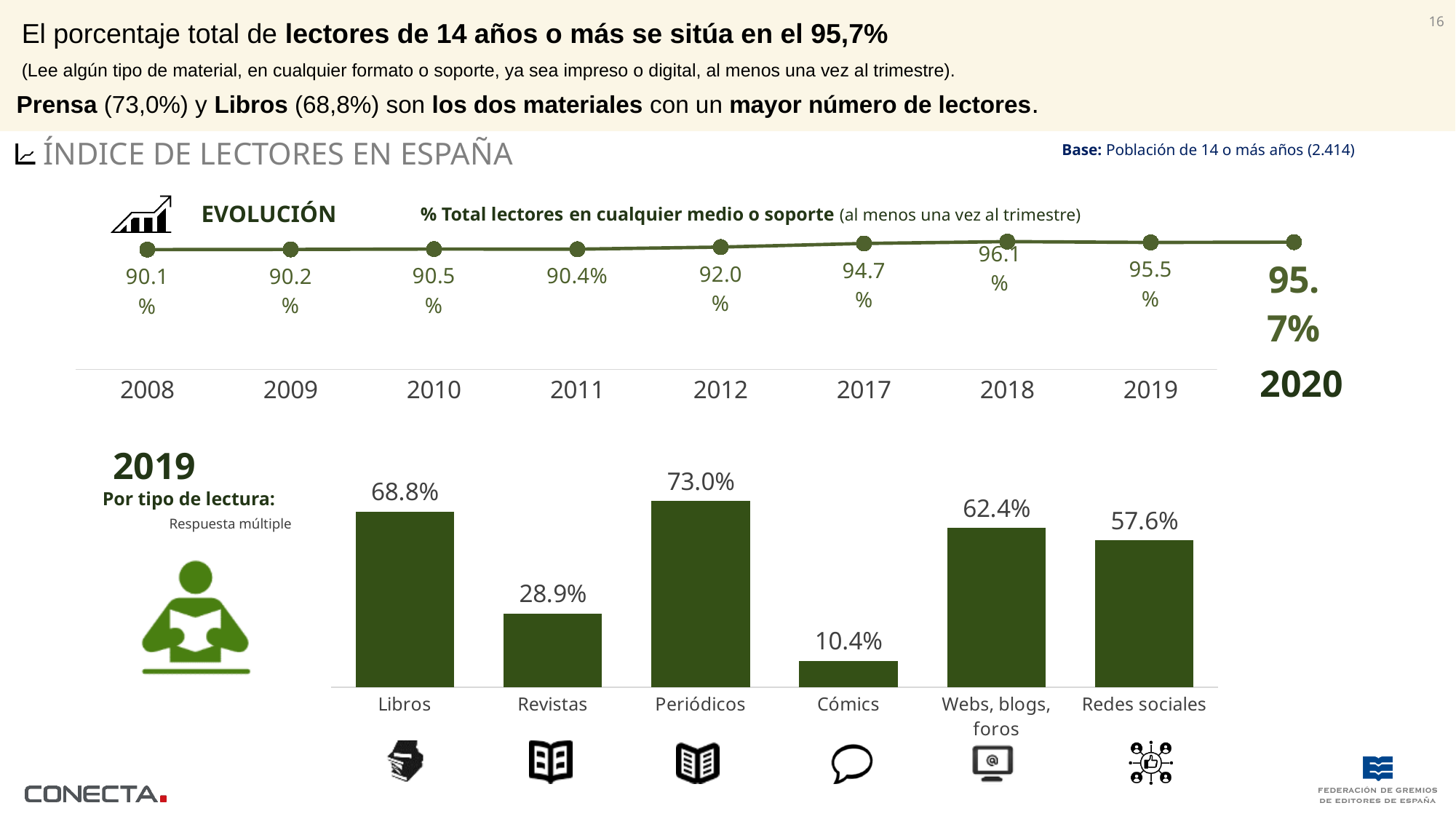
In the bar chart 'Por tipo de lectura', which category has the highest value? Periódicos How many data points are plotted in the 'Evolución' line chart? 9 In the bar chart 'Por tipo de lectura', which is larger, Webs, blogs, foros or Redes sociales? Webs, blogs, foros In the bar chart 'Por tipo de lectura', which category has the lowest value? Cómics In the bar chart 'Por tipo de lectura', what is the difference between Libros and Revistas? 39.9% In the 'Evolución' line chart, what is the difference between the 2020 and 2008 values? 5.6% In the bar chart 'Por tipo de lectura', what is the value for Cómics? 10.4% In the bar chart 'Por tipo de lectura', what is the value for Periódicos? 73.0% In the 'Evolución' line chart, what is the value for 2012? 92.0% What kind of chart is the 'Por tipo de lectura' chart? Bar chart How many categories are shown in the bar chart 'Por tipo de lectura'? 6 In the 'Evolución' line chart, which year has the highest value? 2018